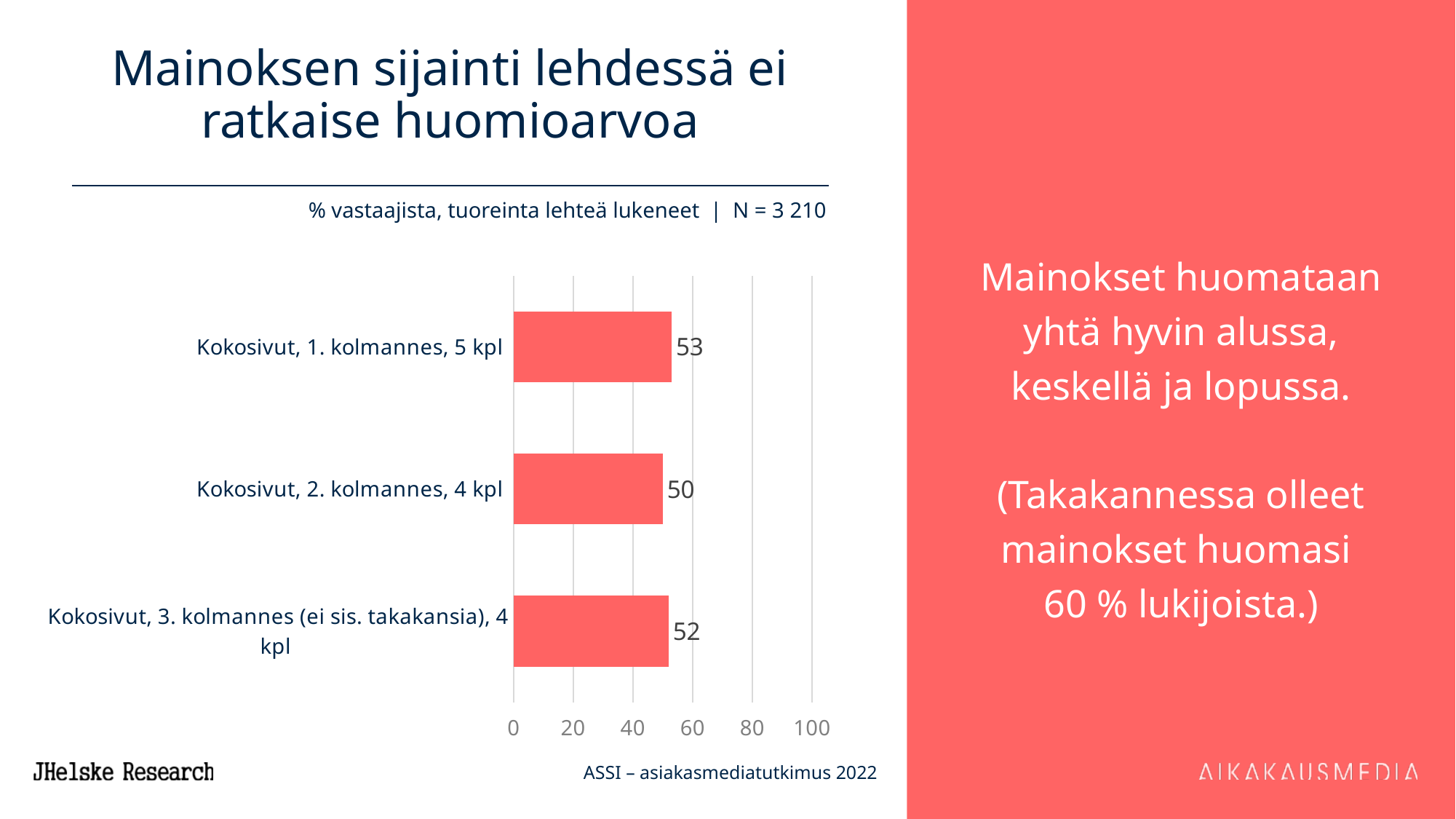
Is the value for "Kokosivut, 1. kolmannes, 5 kpl" greater or less than 60? less What is the difference between the values for "Kokosivut, 1. kolmannes, 5 kpl" and "Kokosivut, 2. kolmannes, 4 kpl"? 3 What is the highest tick value shown on the value axis? 100 Which category has the highest value? Kokosivut, 1. kolmannes, 5 kpl What is the sample size (N) stated in the chart subtitle? N = 3 210 What is the value for "Kokosivut, 3. kolmannes (ei sis. takakansia), 4 kpl"? 52 Which category has the lowest value? Kokosivut, 2. kolmannes, 4 kpl What kind of chart is shown on the slide? bar chart Which is larger: the value for "Kokosivut, 3. kolmannes (ei sis. takakansia), 4 kpl" or for "Kokosivut, 2. kolmannes, 4 kpl"? Kokosivut, 3. kolmannes (ei sis. takakansia), 4 kpl How many categories are shown in the chart? 3 What is the value for "Kokosivut, 1. kolmannes, 5 kpl"? 53 What is the value for "Kokosivut, 2. kolmannes, 4 kpl"? 50